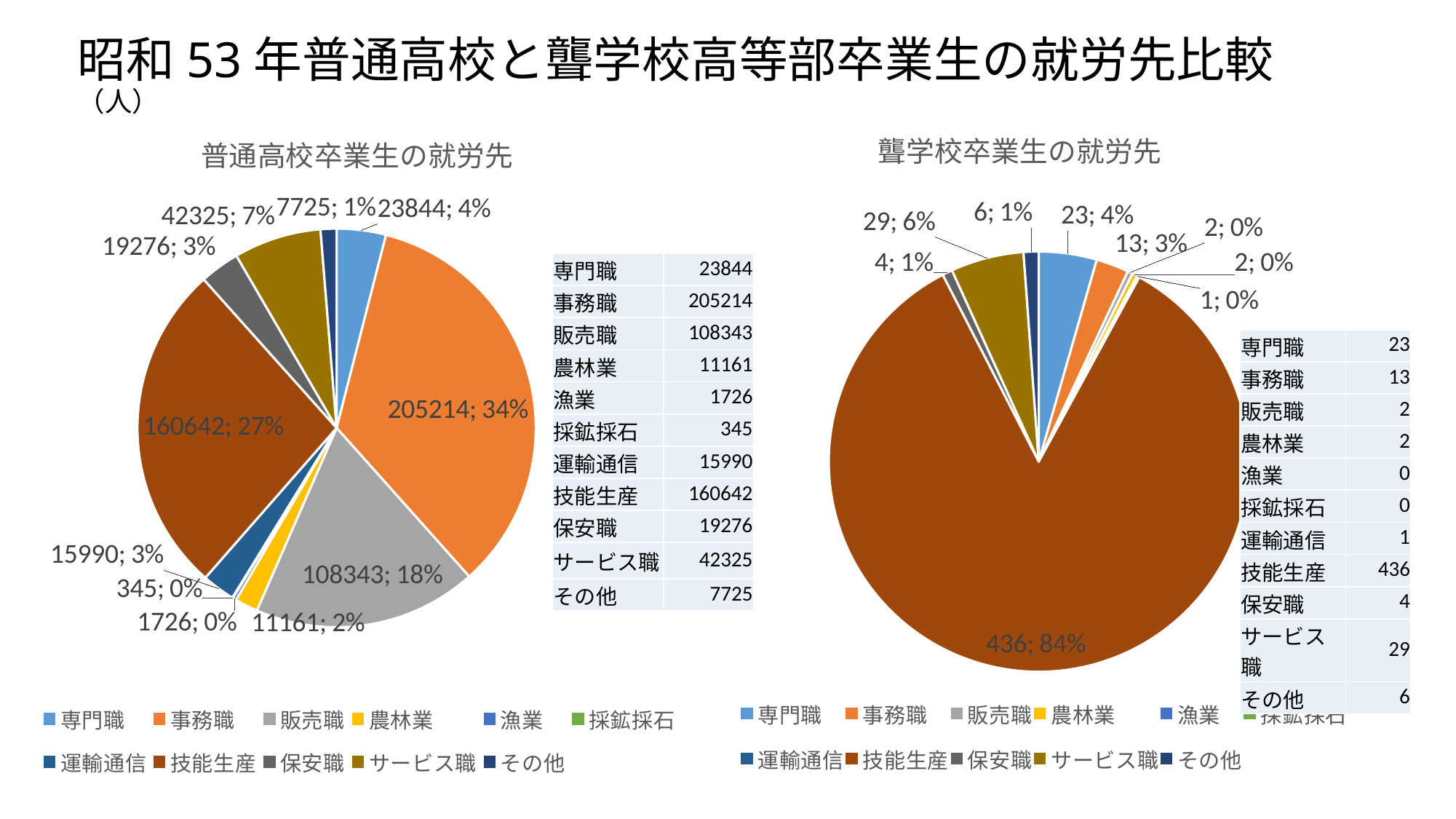
In the 聾学校卒業生の就労先 chart, what is the difference between サービス職 and 専門職? 6 In the 聾学校卒業生の就労先 chart, which is larger, 専門職 or サービス職? サービス職 In the 普通高校卒業生の就労先 chart, what is the difference between 事務職 and 販売職? 96871 How many categories does the legend of the 聾学校卒業生の就労先 chart list? 11 In the 普通高校卒業生の就労先 chart, what is the value for 事務職? 205214 In the 普通高校卒業生の就労先 chart, what share of the pie does 技能生産 represent? 27% In the 聾学校卒業生の就労先 chart, what is the value for 技能生産? 436 What type of chart is used in the 普通高校卒業生の就労先 chart? pie chart In the 聾学校卒業生の就労先 chart, what share of the pie does 技能生産 represent? 84% What is the title of the chart on the left side of the slide? 普通高校卒業生の就労先 In the 普通高校卒業生の就労先 chart, which category has the largest value? 事務職 In the 普通高校卒業生の就労先 chart, which category has the smallest value? 採鉱採石